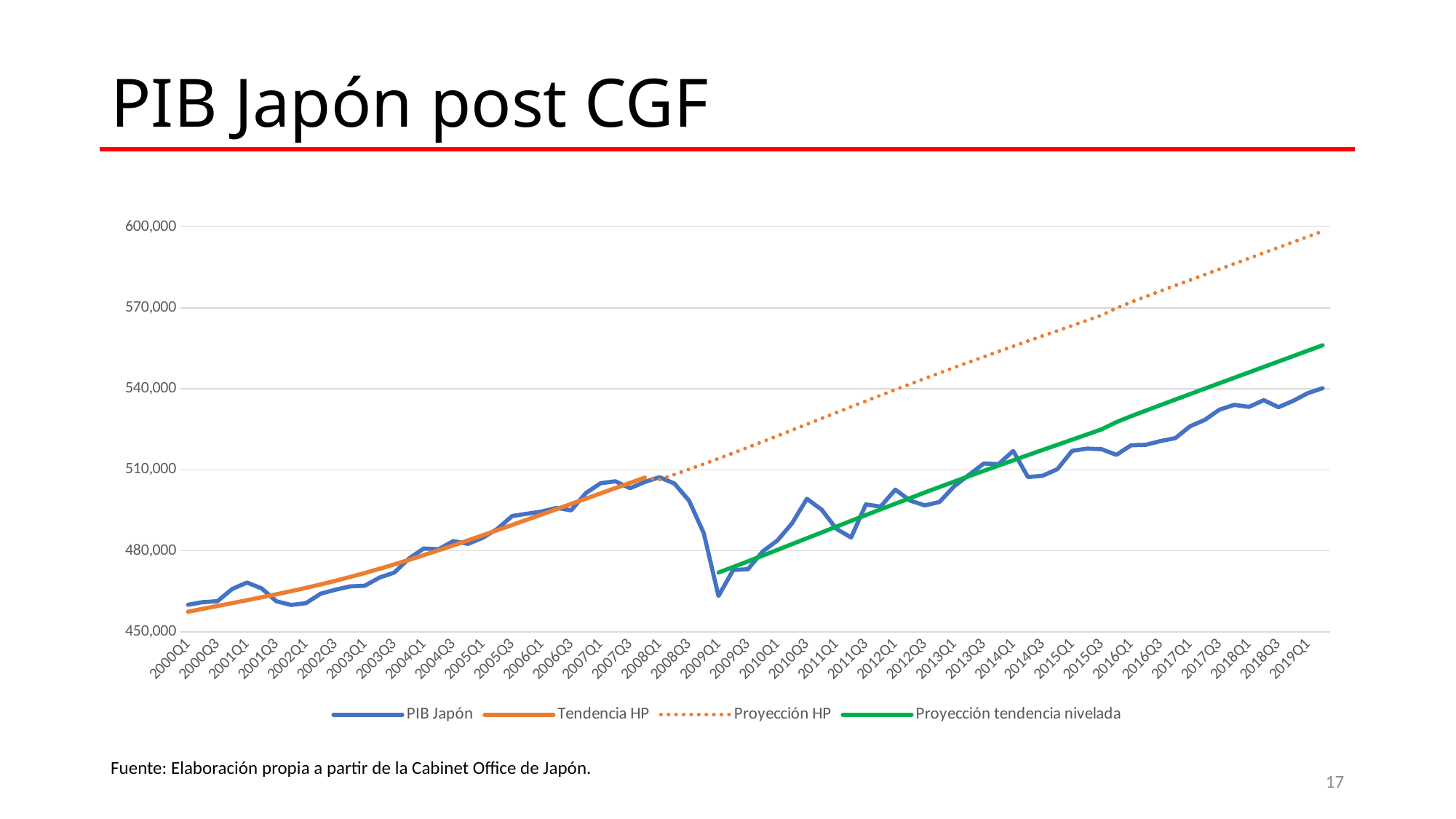
Is the value of PIB Japón at 2000Q1 greater or less than 480,000? less Does PIB Japón rise or fall between 2008Q1 and 2009Q1? fall At 2019Q1, which is higher: Proyección HP or Proyección tendencia nivelada? Proyección HP Is the value of PIB Japón at 2009Q1 greater or less than 480,000? less Does the Proyección HP series rise or fall from 2008Q1 to 2019Q1? rise What kind of chart is shown on the slide? line chart Is the value of Proyección HP at 2019Q1 greater or less than 570,000? greater Which series is drawn as a dotted line? Proyección HP At 2019Q1, which is higher: Proyección tendencia nivelada or PIB Japón? Proyección tendencia nivelada How many series does the legend list? 4 What is the title of the slide's chart? PIB Japón post CGF